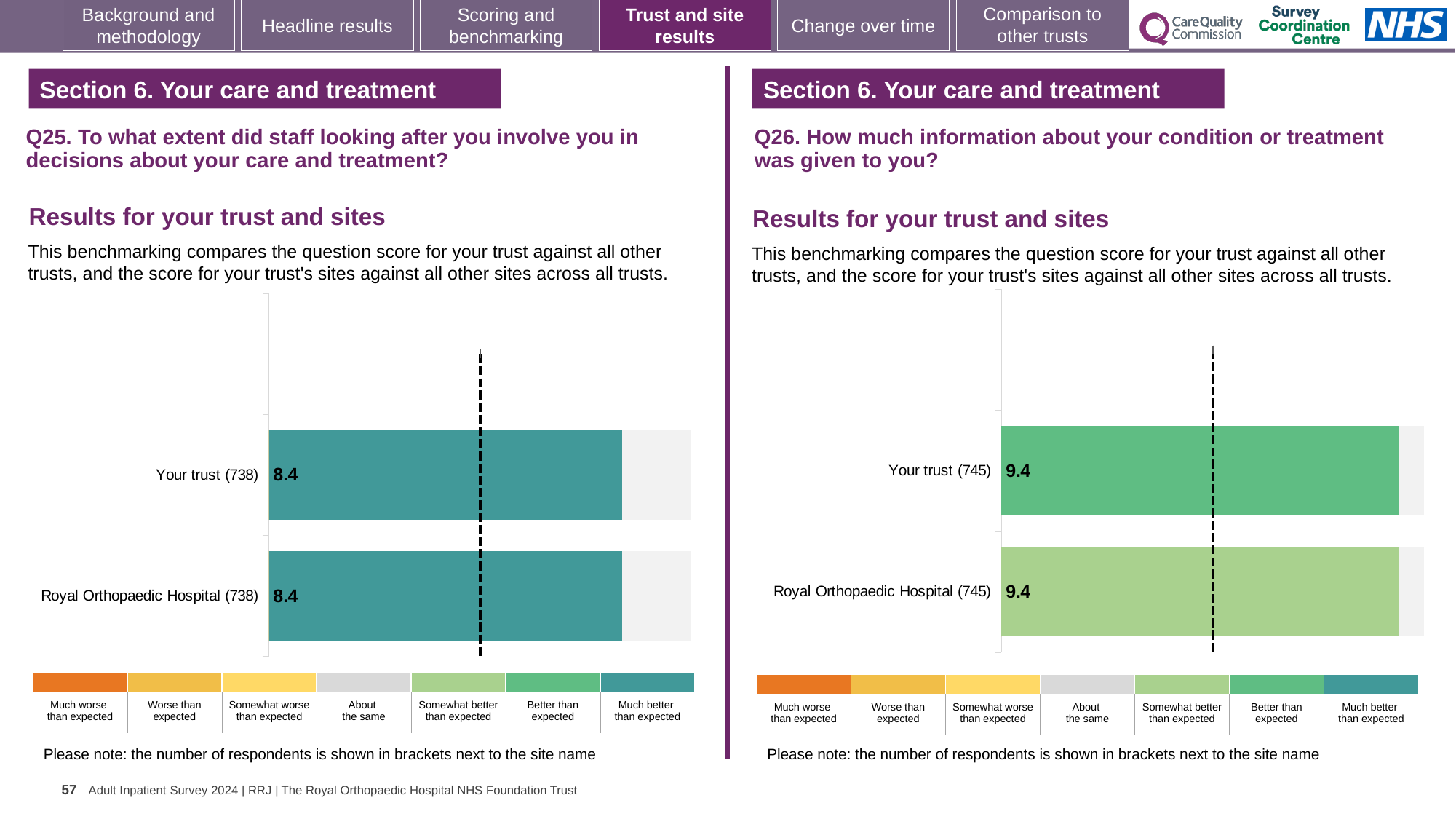
How many bars are plotted in the Q25 chart on the left? 2 In the Q26 chart on the right, which benchmark category does the colour of the Your trust (745) bar correspond to in the legend? Better than expected In the Q25 chart on the left, what is the difference between the score for Your trust and the score for Royal Orthopaedic Hospital? 0.0 In the Q25 chart on the left, what is the score for Your trust (738)? 8.4 In the Q26 chart on the right, what is the score for Your trust (745)? 9.4 In the Q25 chart on the left, what is the score for Royal Orthopaedic Hospital (738)? 8.4 In the Q26 chart on the right, what is the score for Royal Orthopaedic Hospital (745)? 9.4 In the Q26 chart on the right, how many respondents are shown in brackets next to Royal Orthopaedic Hospital? 745 In the Q26 chart on the right, what is the difference between the score for Your trust and the score for Royal Orthopaedic Hospital? 0.0 In the Q25 chart on the left, how many respondents are shown in brackets next to Your trust? 738 How many bars are plotted in the Q26 chart on the right? 2 What kind of chart is used for the Q25 results on the left? Bar chart